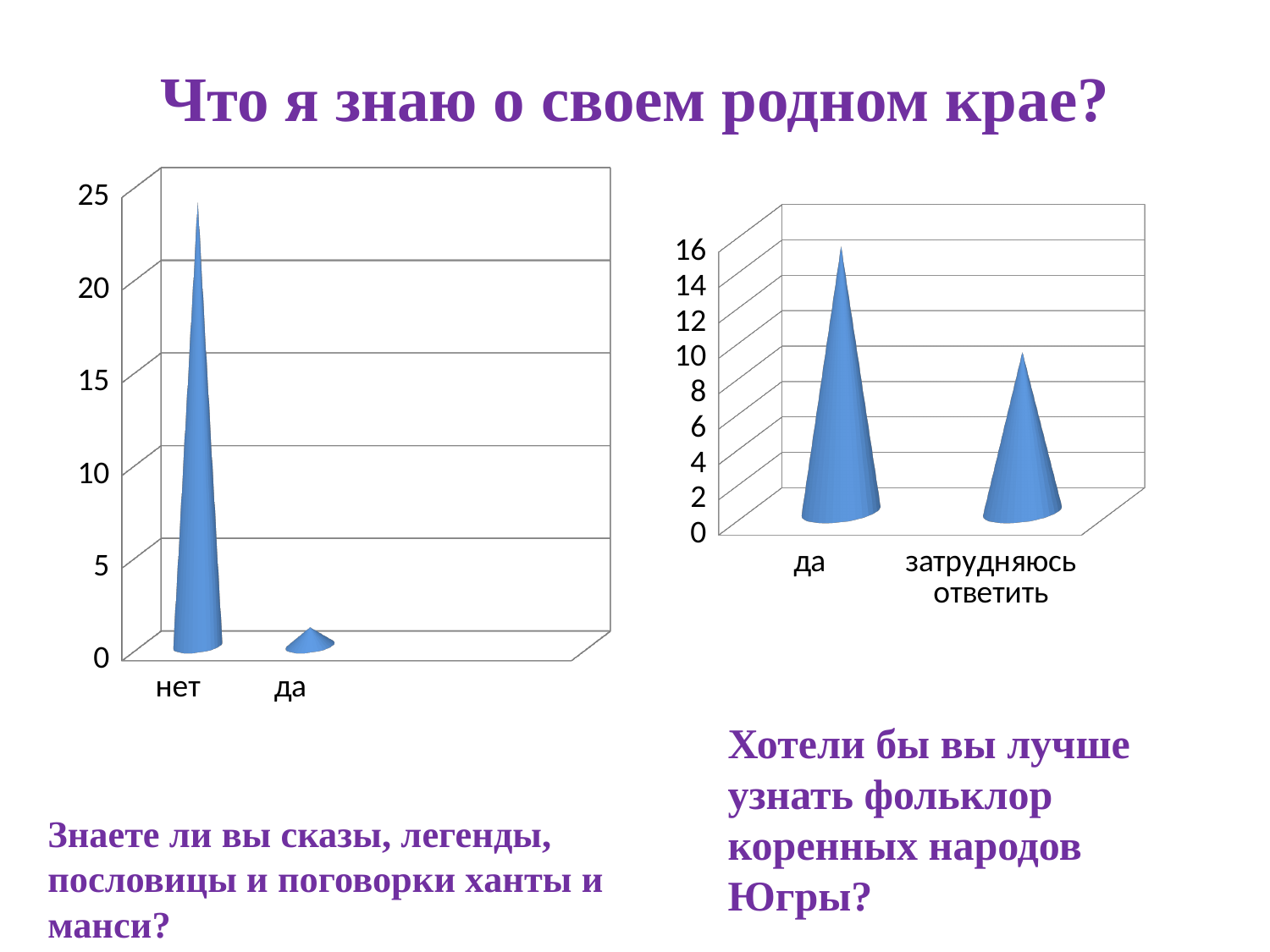
In the left chart, which category has the lowest value? да In the right chart, which category has the highest value? да What kind of chart is the left chart? bar chart In the left chart, how many categories are shown on the x axis? 2 What is the highest value shown on the vertical axis of the right chart? 16 In the right chart, is the value for да greater or less than 10? greater In the right chart, is the value for затрудняюсь ответить greater or less than 14? less In the left chart, is the value for да greater or less than 5? less In the left chart, which category has the highest value? нет In the right chart, how many categories are shown on the x axis? 2 In the right chart, which is larger, да or затрудняюсь ответить? да